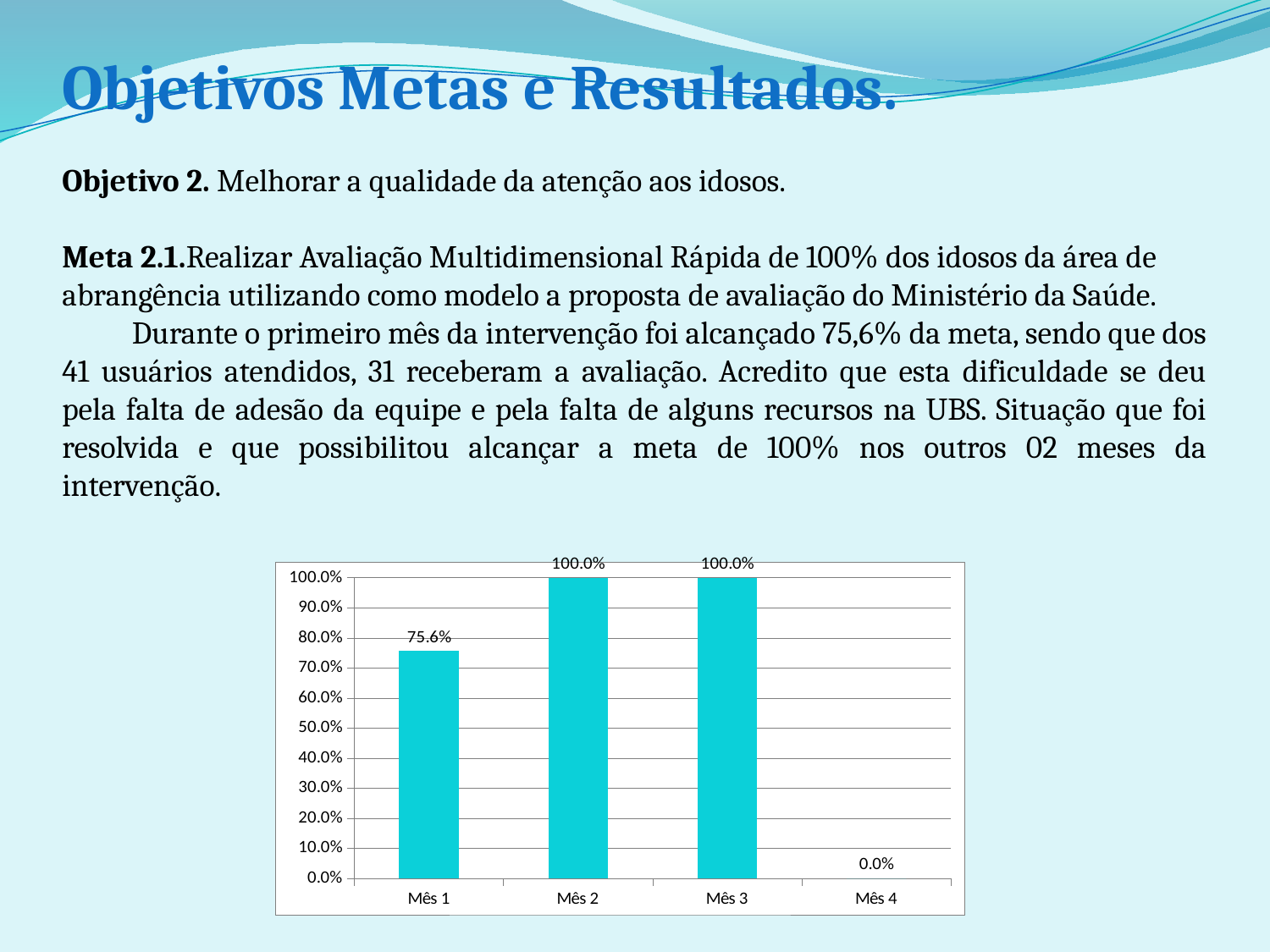
How many categories are shown on the x axis? 4 What is the value for Mês 1? 75.6% Is the value for Mês 1 greater or less than 70.0%? greater What is the value for Mês 4? 0.0% What colour are the bars in the chart? cyan Do the values rise or fall from Mês 1 to Mês 2? rise What is the highest value shown on the y axis? 100.0% What is the value for Mês 2? 100.0% Which is larger, the value for Mês 1 or the value for Mês 3? Mês 3 What is the difference between the values for Mês 2 and Mês 1? 24.4% Which category has the lowest value? Mês 4 What kind of chart is shown on the slide? bar chart